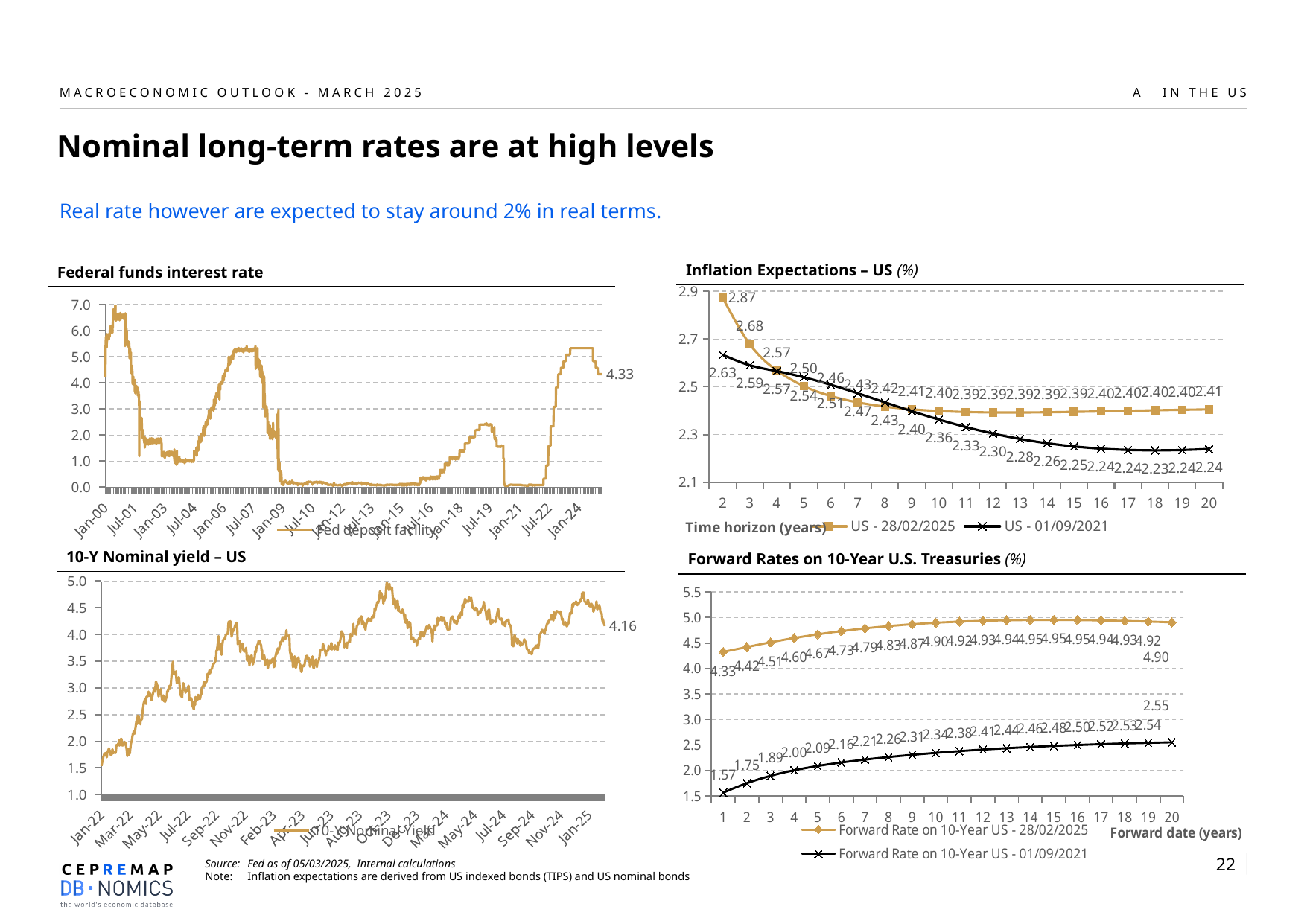
In the Forward Rates on 10-Year U.S. Treasuries chart, what is the value for Forward Rate on 10-Year US - 01/09/2021 at a forward date of 1 year? 1.57 In the Forward Rates on 10-Year U.S. Treasuries chart, how many forward dates are plotted on the x axis? 20 In the Inflation Expectations – US chart, how many series does the legend list? 2 In the Federal funds interest rate chart, what is the latest value labelled at the end of the line? 4.33 In the Inflation Expectations – US chart, what is the difference between the US - 28/02/2025 and US - 01/09/2021 values at a time horizon of 2 years? 0.24 In the 10-Y Nominal yield – US chart, what is the latest value labelled at the end of the line? 4.16 In the Forward Rates on 10-Year U.S. Treasuries chart, what is the difference between the 28/02/2025 and 01/09/2021 forward rates at a forward date of 20 years? 2.35 In the Inflation Expectations – US chart, what is the value for US - 28/02/2025 at a time horizon of 2 years? 2.87 In the Inflation Expectations – US chart, does the US - 01/09/2021 series rise or fall as the time horizon increases? fall What kind of chart is the Federal funds interest rate chart? line chart In the Inflation Expectations – US chart, what is the value for US - 01/09/2021 at a time horizon of 2 years? 2.63 In the Forward Rates on 10-Year U.S. Treasuries chart, what is the value for Forward Rate on 10-Year US - 28/02/2025 at a forward date of 1 year? 4.33